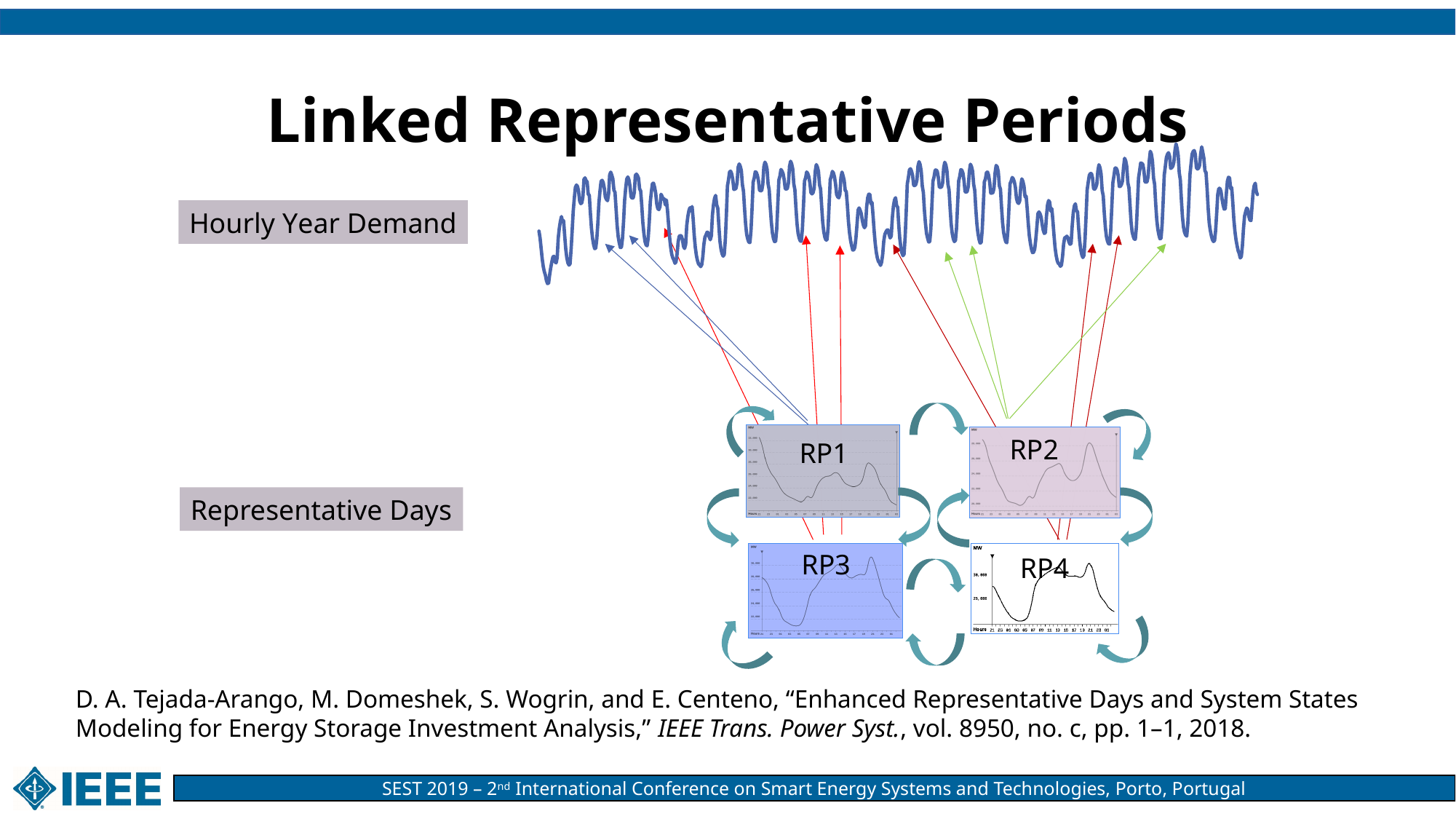
Which representative day chart is positioned at the bottom right of the group of four? RP4 In the RP4 chart, what unit is shown on the vertical axis? MW How many representative day charts are shown on the slide? 4 What kind of chart is used for each of the representative days (RP1 to RP4)? line chart What are the labels of the four representative day charts? RP1, RP2, RP3, RP4 What kind of chart is the "Hourly Year Demand" chart at the top of the slide? line chart Which representative day chart is positioned at the top left of the group of four? RP1 In the RP4 chart, what is the label of the horizontal axis? Hours